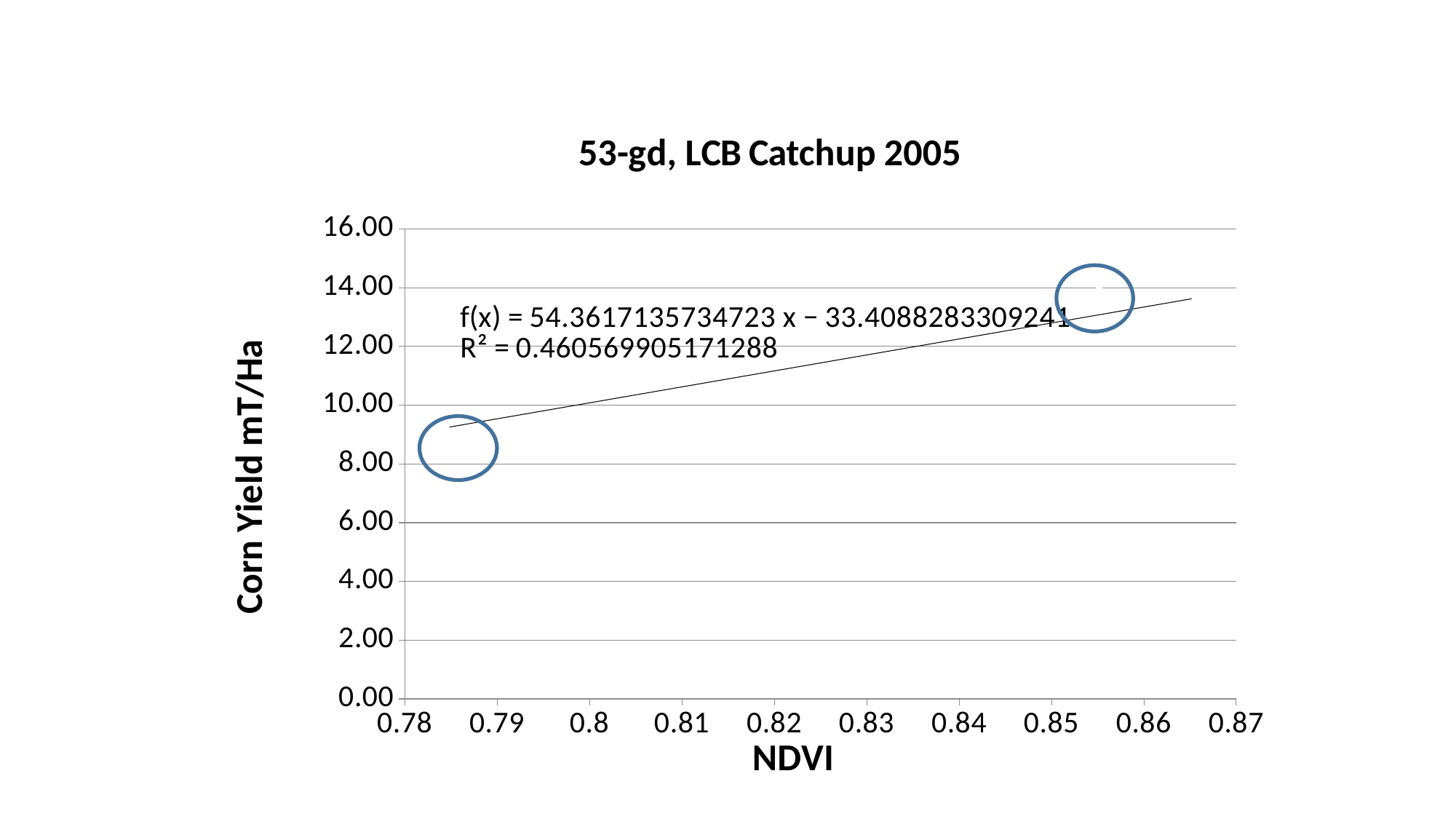
What is the slope of the fitted line f(x) shown on the chart? 54.3617135734723 What is the lowest tick value shown on the horizontal NDVI axis? 0.78 Is the trendline value at NDVI 0.86 greater or less than 12.00? greater Does the trendline rise or fall as NDVI increases? rise What is the R² value printed on the chart? 0.460569905171288 What is the label of the vertical axis? Corn Yield mT/Ha Is the trendline value at NDVI 0.79 greater or less than 10.00? less What is the intercept of the fitted line f(x) shown on the chart? −33.4088283309241 What is the title of the chart? 53-gd, LCB Catchup 2005 What kind of chart is shown on the slide? scatter chart with a trendline What is the highest tick value shown on the vertical axis? 16.00 How many tick labels are shown on the horizontal NDVI axis? 10